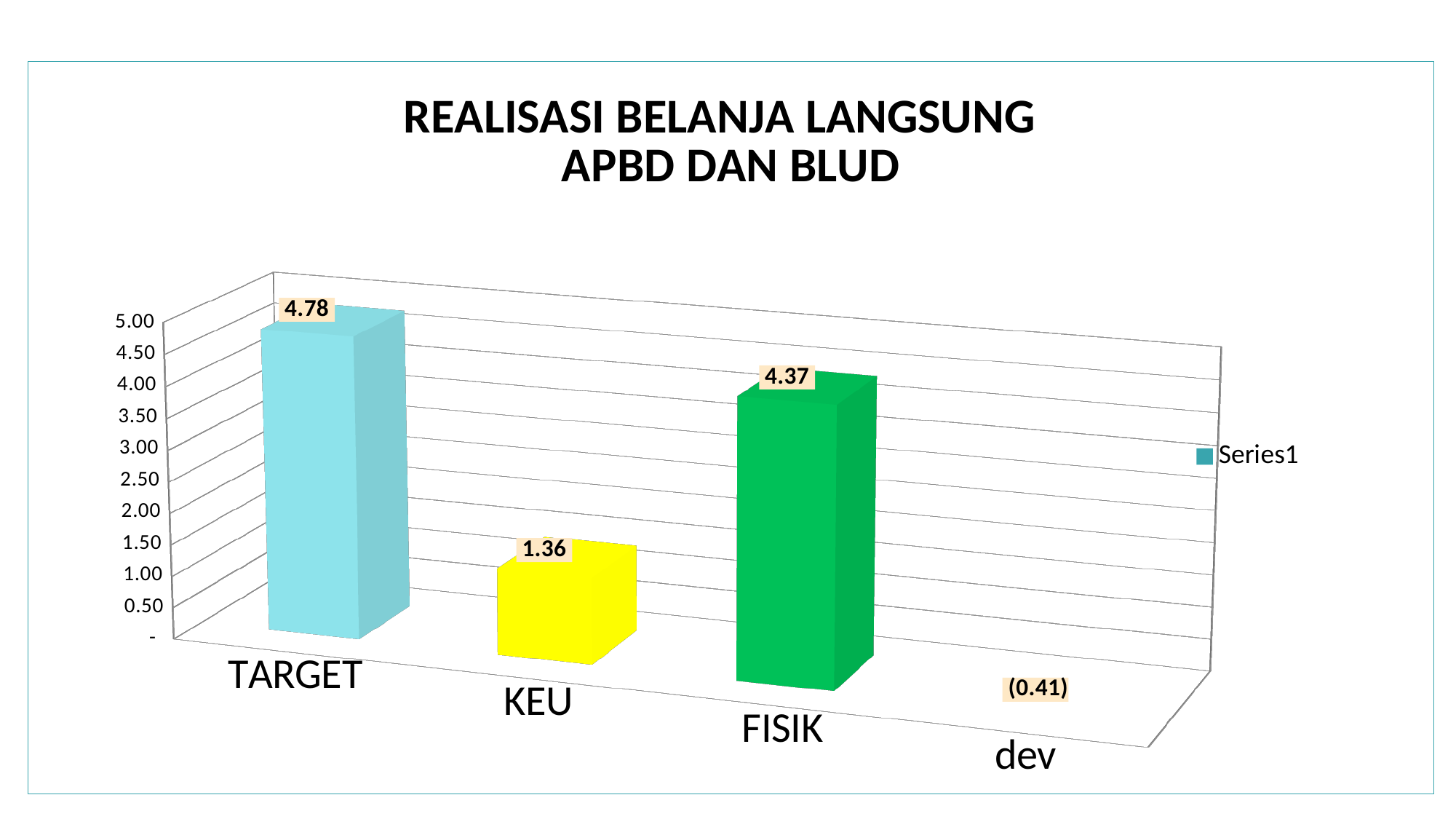
What is the difference between the values for TARGET and KEU? 3.42 Which category has the highest value? TARGET What is the value for KEU? 1.36 How many series does the legend list? 1 What is the value for FISIK? 4.37 What kind of chart is shown on the slide? bar chart What value is printed for dev? (0.41) Is the value for KEU greater or less than 1.50? less What is the value for TARGET? 4.78 How many categories are shown on the x axis? 4 Which is larger, the value for FISIK or the value for KEU? FISIK What is the difference between the values for TARGET and FISIK? 0.41